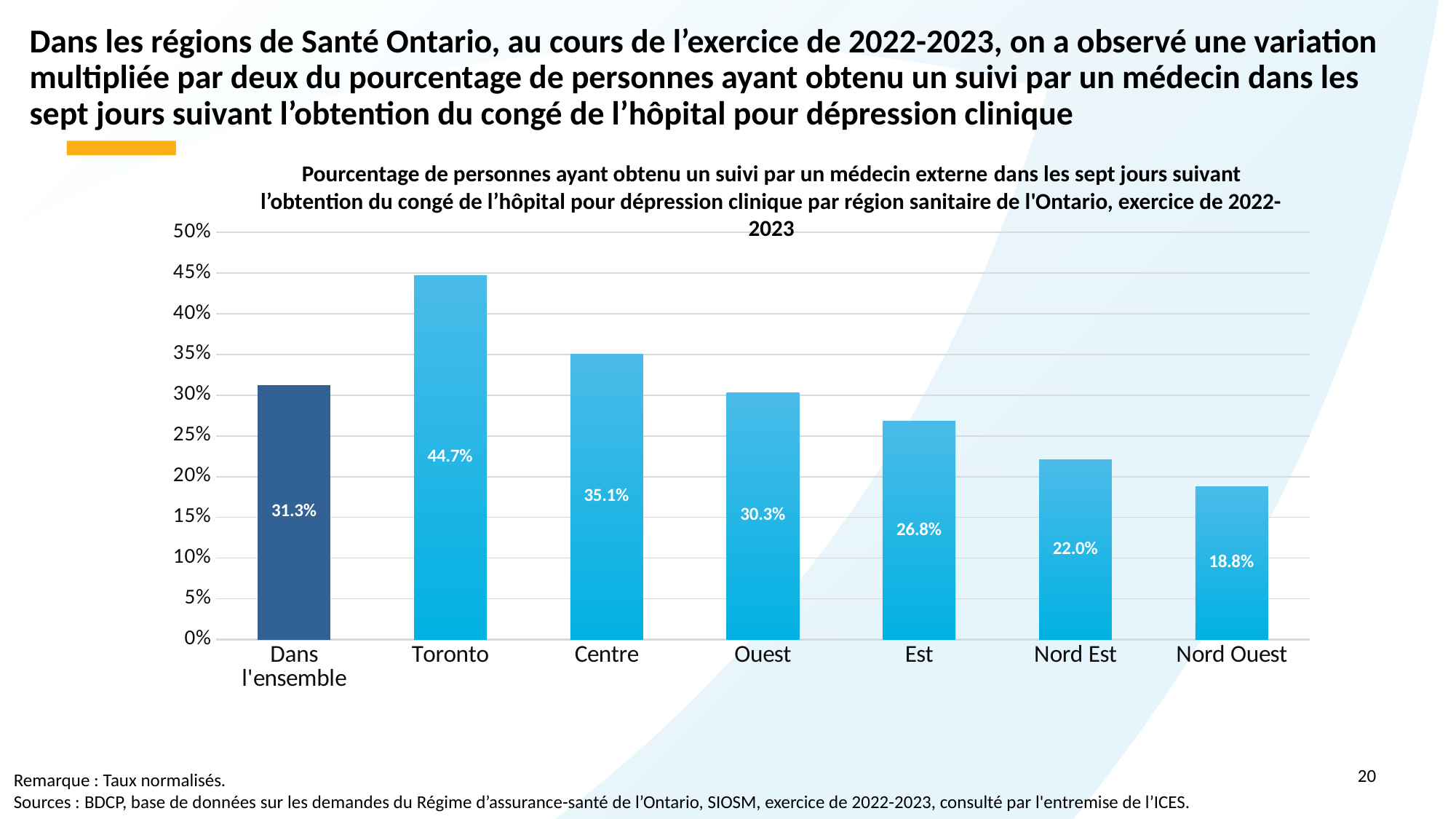
What is the difference between the values for Toronto and Nord Ouest? 25.9% How many bars are shown in the chart? 7 Which region has the lowest percentage? Nord Ouest Do the values rise or fall from Toronto to Nord Ouest along the x axis? Fall Which bar is shown in a darker blue colour than the others? Dans l'ensemble What is the value for Dans l'ensemble? 31.3% What kind of chart is shown on the slide? Bar chart Which region has the highest percentage? Toronto What is the value for Toronto? 44.7% What is the value for Nord Ouest? 18.8% Is the value for Est greater or less than 25%? greater Which is larger, the value for Centre or the value for Ouest? Centre